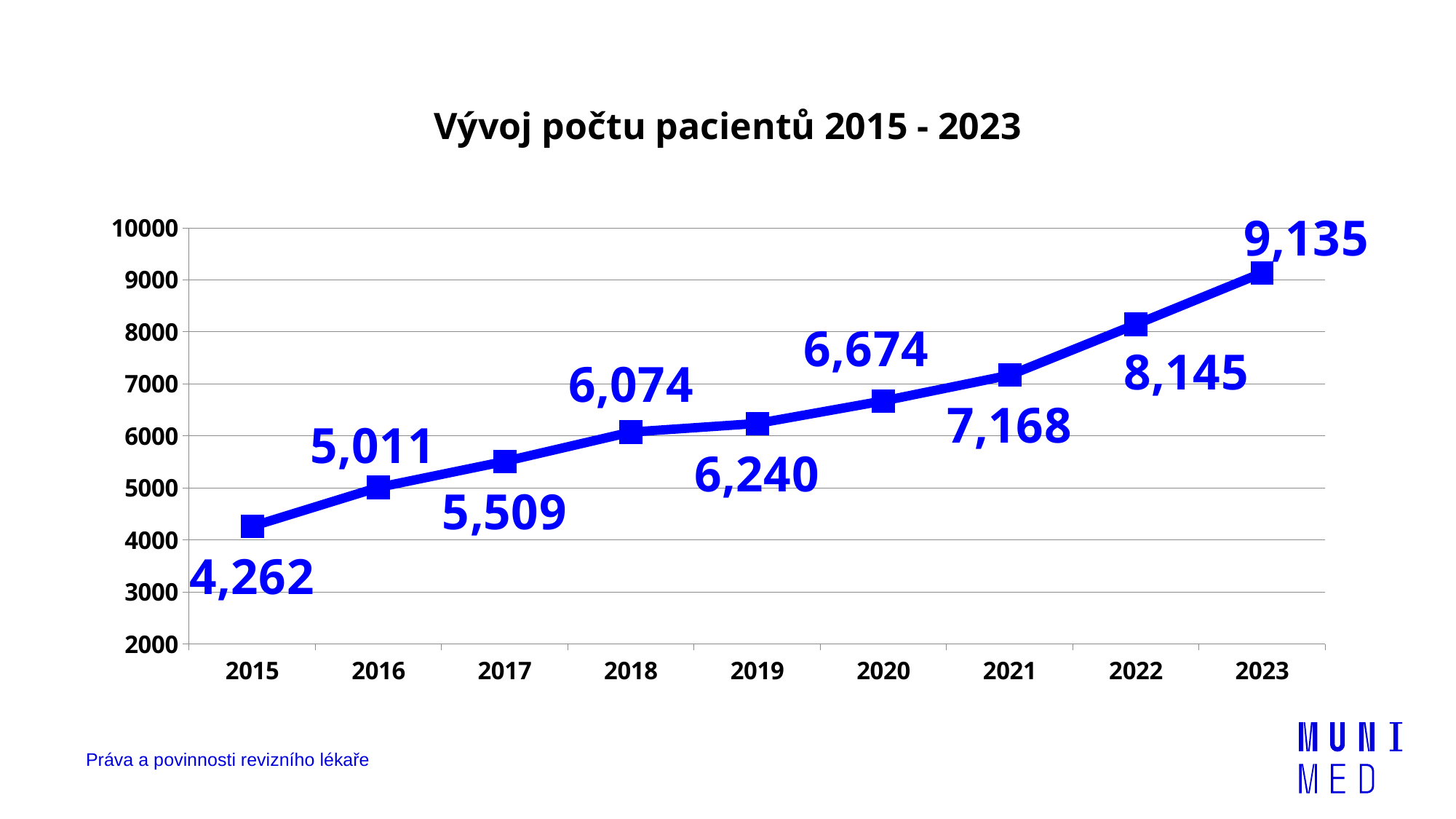
What is the value for 2022? 8,145 What is the value for 2019? 6,240 What is the value for 2015? 4,262 Which year has the lowest value? 2015 Which is larger, the value for 2018 or the value for 2017? 2018 What is the difference between the values for 2021 and 2020? 494 What kind of chart is shown? line chart Do the values rise or fall from 2015 to 2023? rise What is the difference between the values for 2023 and 2015? 4,873 How many years are plotted on the chart? 9 Which year has the highest value? 2023 Is the value for 2020 greater or less than 7000? less